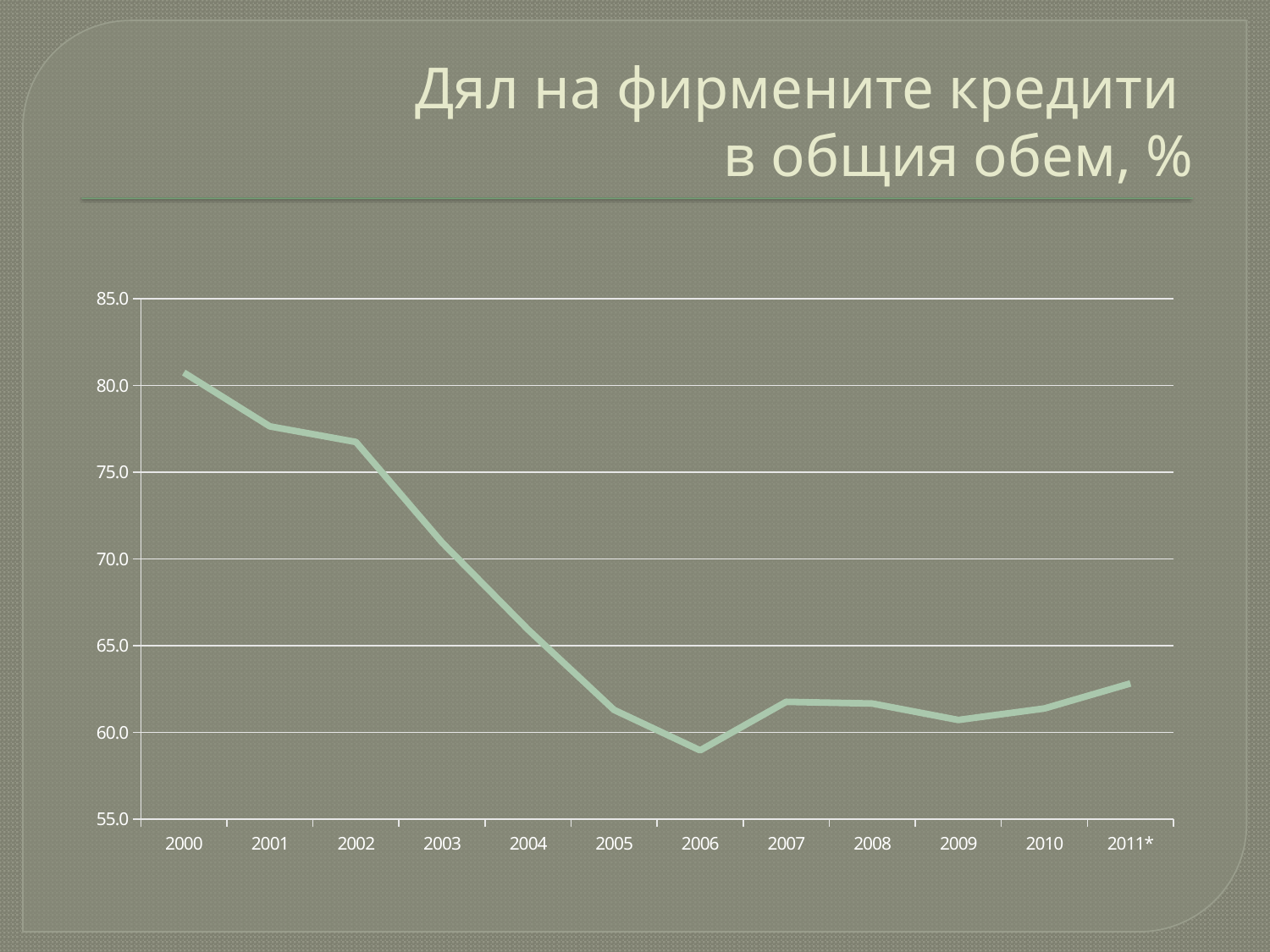
What is the title of the slide? Дял на фирмените кредити в общия обем, % How many years are plotted along the x axis? 12 Do the values rise or fall from 2000 to 2006? fall Which year has the lowest share of company loans? 2006 Which is larger, the value for 2000 or the value for 2011*? 2000 Is the value for 2002 greater or less than 75.0? greater Is the value for 2011* greater or less than 60.0? greater Is the value for 2007 greater or less than 65.0? less Which year has the highest share of company loans? 2000 What kind of chart is shown on the slide? line chart